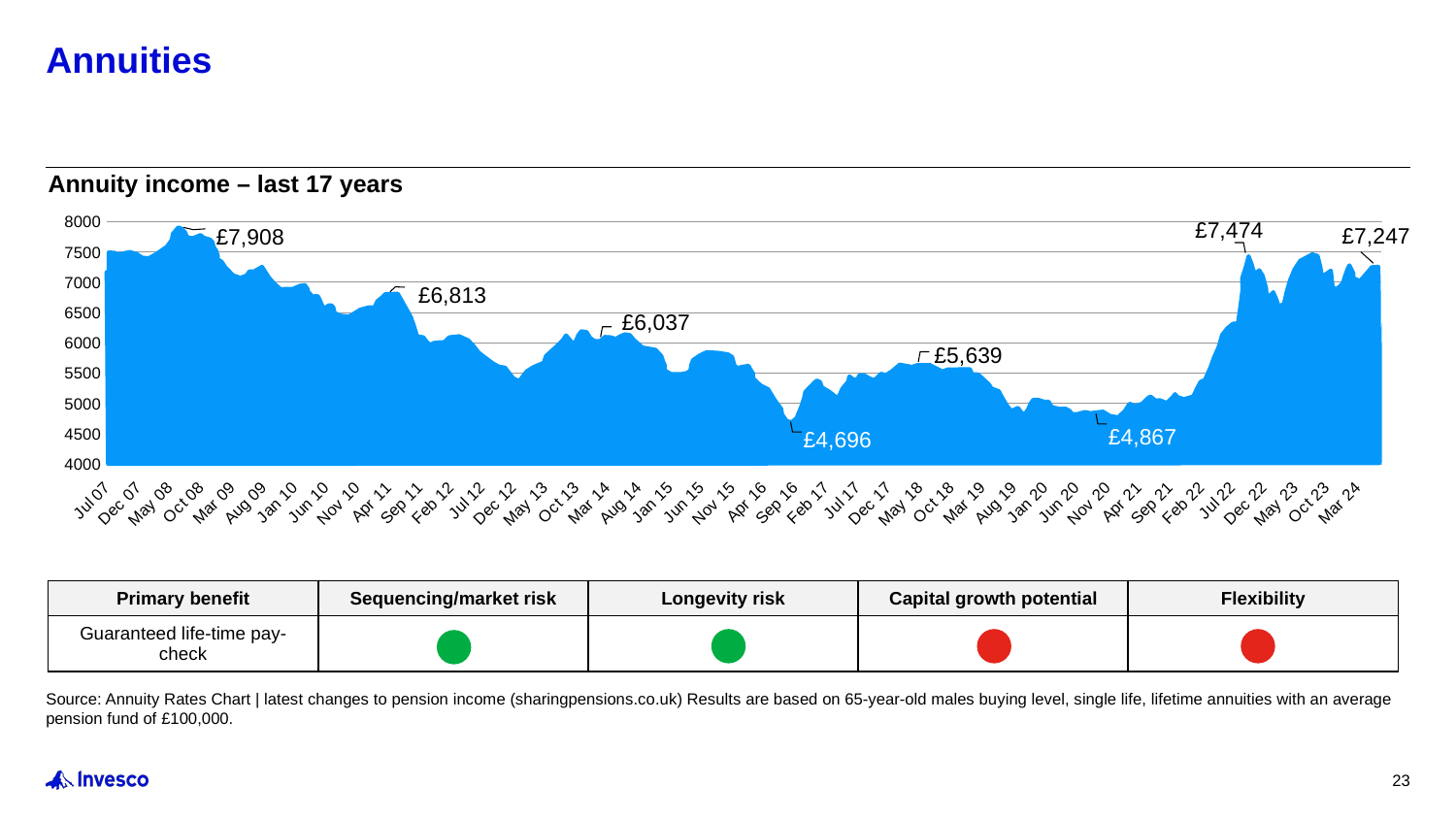
What is the last labelled value on the chart, near Mar 24? £7,247 What is the labelled value near Nov 20? £4,867 What is the difference between the labelled values £7,474 and £4,867? £2,607 What is the lowest value labelled on the chart? £4,696 What is the title of the chart? Annuity income – last 17 years Is the annuity income at Jul 07 greater or less than 7000? greater What kind of chart is shown on the slide? area chart What is the highest value labelled on the chart? £7,908 Does annuity income rise or fall between Jul 07 and Apr 16? fall What is the difference between the labelled values £7,908 and £7,247? £661 How many data labels are printed on the chart? 8 Which labelled value is larger, £6,813 or £6,037? £6,813